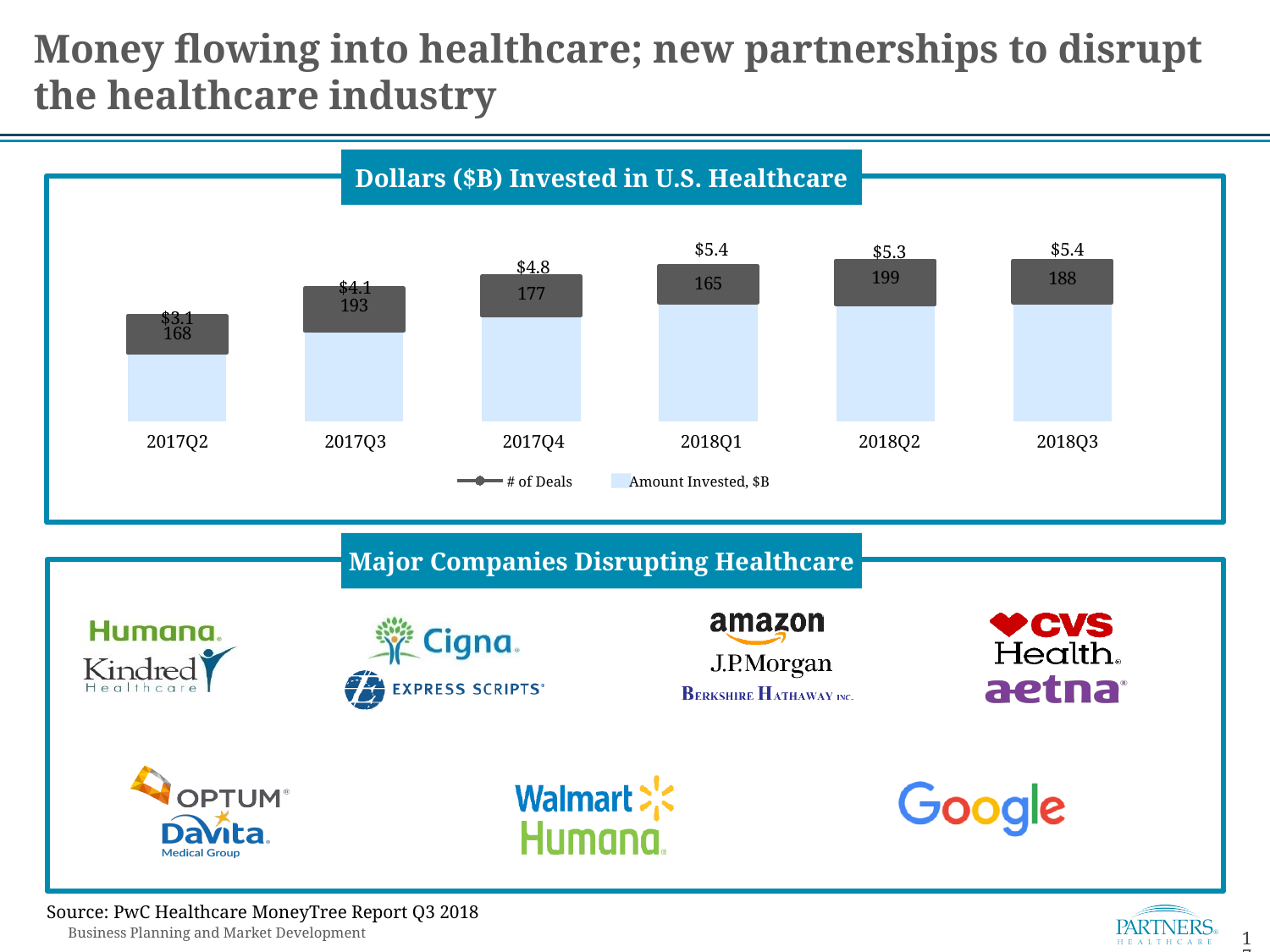
Which quarter had the highest number of deals? 2018Q2 What is the difference in amount invested between 2018Q3 and 2017Q2? $2.3 How many quarters are shown in the chart? 6 What amount was invested in 2017Q4? $4.8 How many deals were there in 2018Q2? 199 Does the amount invested generally rise or fall from 2017Q2 to 2018Q3? rise Which quarter had the lowest amount invested? 2017Q2 How many series does the chart legend list? 2 Which quarter had a larger amount invested, 2017Q3 or 2018Q2? 2018Q2 How many more deals were there in 2018Q2 than in 2018Q1? 34 What amount was invested in U.S. healthcare in 2017Q2? $3.1 Which quarter had the lowest number of deals? 2018Q1